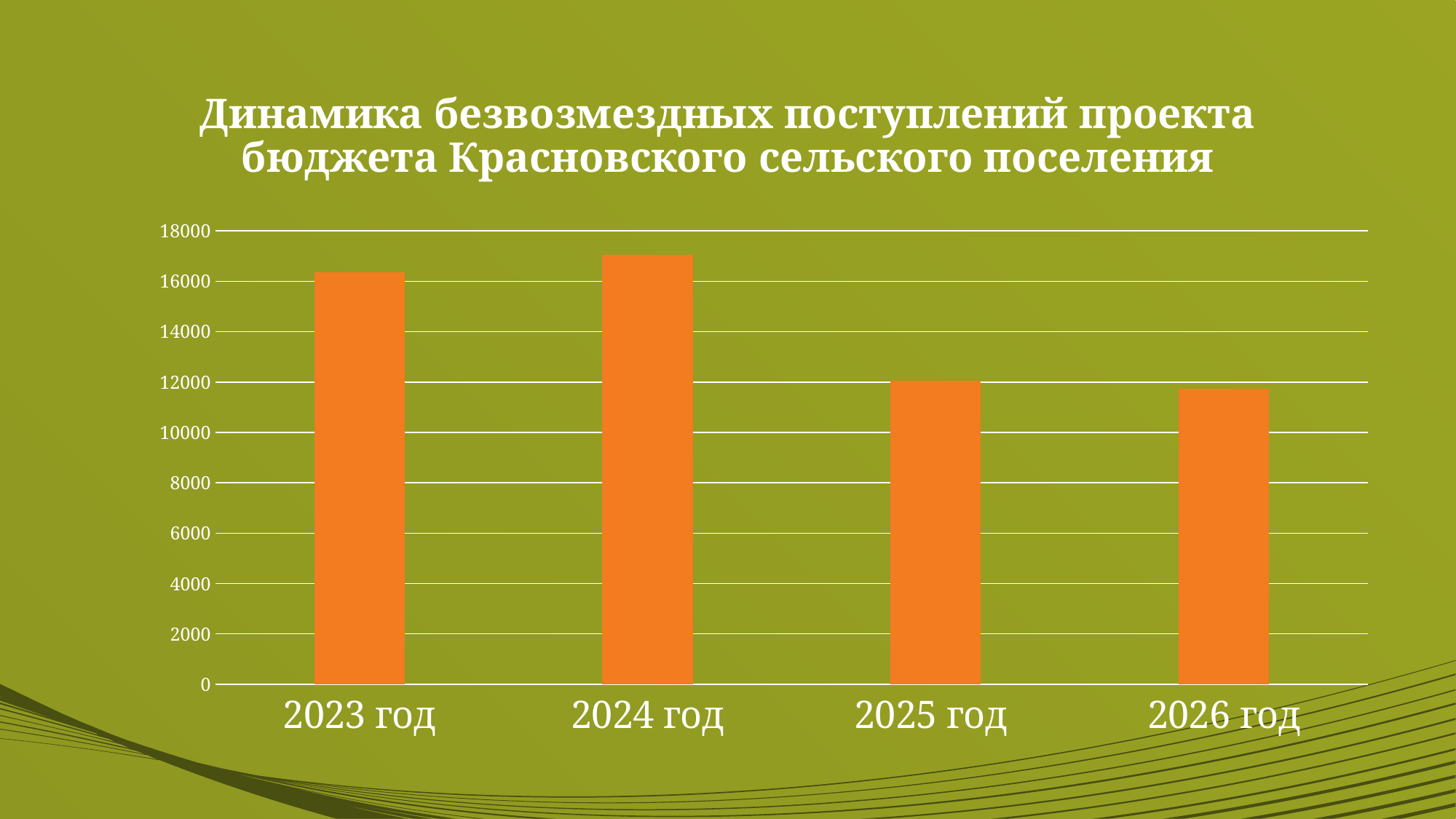
What is the title of the chart? Динамика безвозмездных поступлений проекта бюджета Красновского сельского поселения Is the value for 2024 год greater or less than 16000? greater Which year has the highest value? 2024 год How many years (categories) are shown on the x axis? 4 Do the values rise or fall from 2024 год to 2026 год? fall Which is larger, the value for 2024 год or the value for 2025 год? 2024 год What kind of chart is shown on the slide? bar chart Is the value for 2026 год greater or less than 14000? less Is the value for 2023 год greater or less than 14000? greater Which year has the lowest value? 2026 год